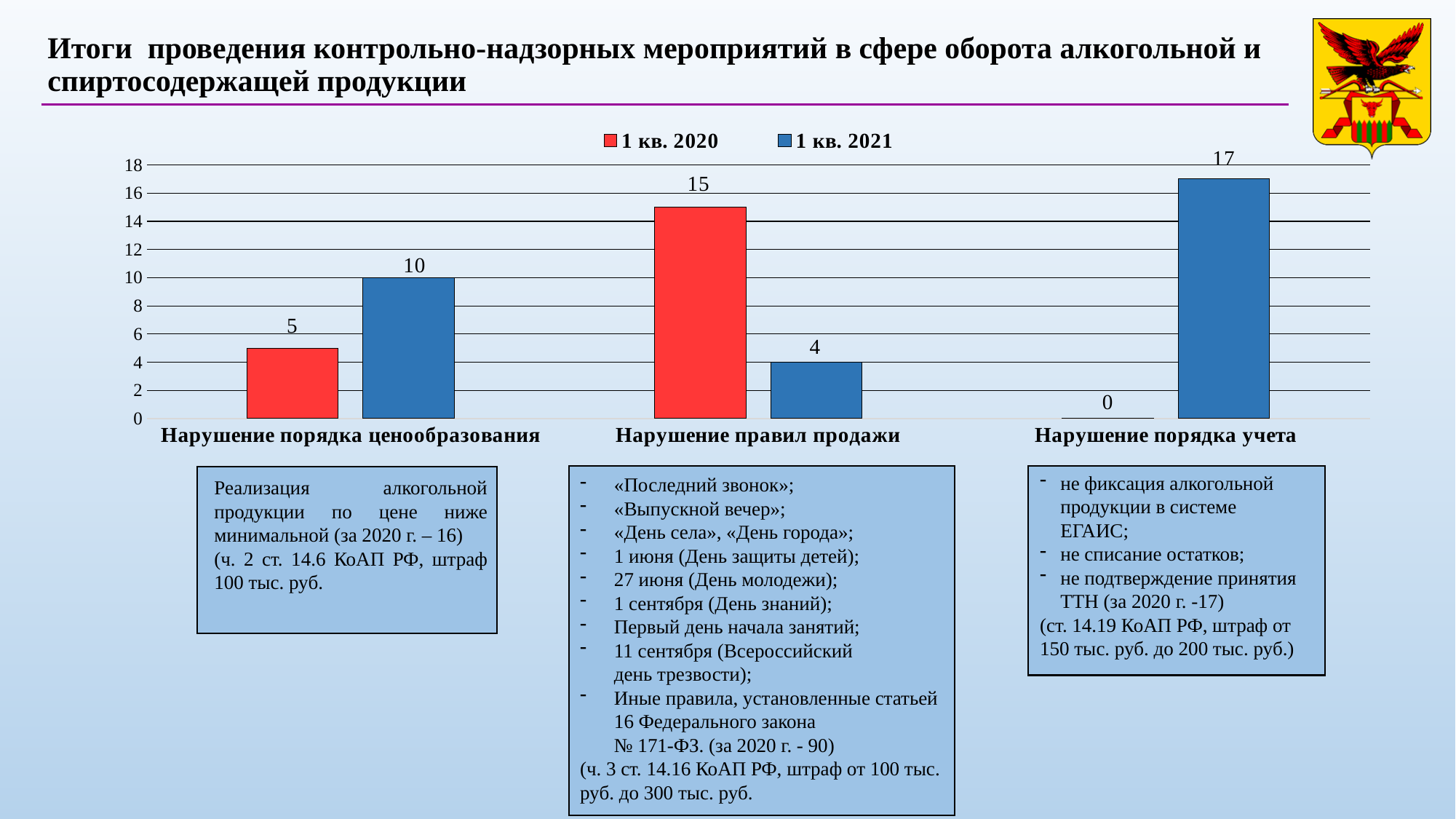
What is the value for 1 кв. 2021 in the category Нарушение правил продажи? 4 What is the value for 1 кв. 2020 in the category Нарушение порядка ценообразования? 5 How many series does the legend list? 2 How many categories are shown on the x axis of the chart? 3 Which category has the highest value for 1 кв. 2021? Нарушение порядка учета What is the difference between the 1 кв. 2020 and 1 кв. 2021 values for Нарушение правил продажи? 11 What is the value for 1 кв. 2021 in the category Нарушение порядка учета? 17 Which category has the lowest value for 1 кв. 2020? Нарушение порядка учета Which is larger for Нарушение порядка ценообразования: the 1 кв. 2020 value or the 1 кв. 2021 value? 1 кв. 2021 What is the value for 1 кв. 2020 in the category Нарушение порядка учета? 0 What is the value for 1 кв. 2020 in the category Нарушение правил продажи? 15 What kind of chart is shown on the slide? Bar chart